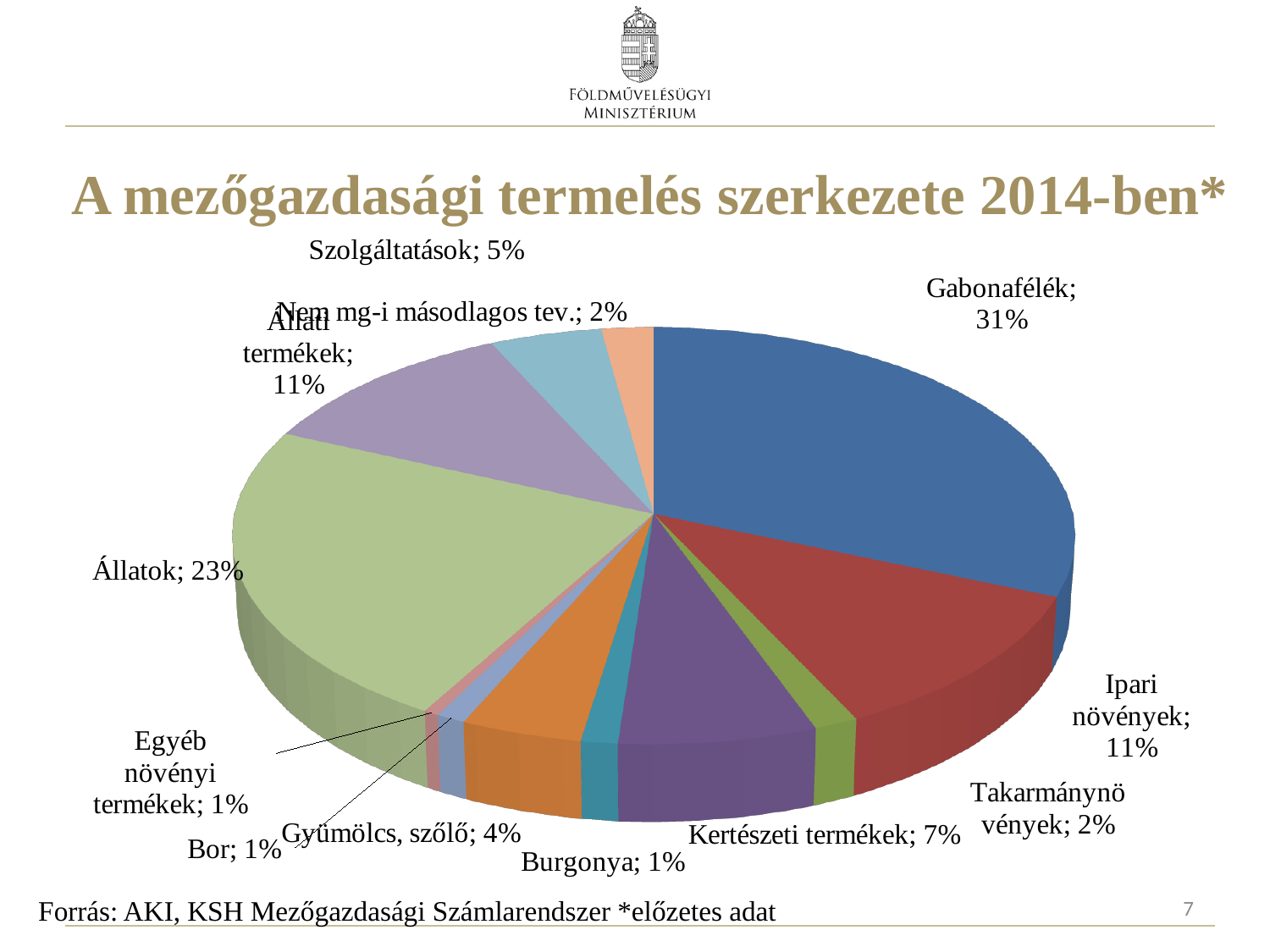
What is the value shown for Takarmánynövények? 2% Which is larger, the share for Ipari növények or the share for Kertészeti termékek? Ipari növények What is the value shown for Gyümölcs, szőlő? 4% Which category has the largest share of the pie? Gabonafélék What is the difference between the shares of Gabonafélék and Állatok? 8% What type of chart is shown on the slide? pie chart What is the value shown for Állatok? 23% How many slices does the pie chart have? 12 What share of the pie does Gabonafélék have? 31% What is the value shown for Kertészeti termékek? 7% What is the value shown for Szolgáltatások? 5% What is the title of the chart on the slide? A mezőgazdasági termelés szerkezete 2014-ben*